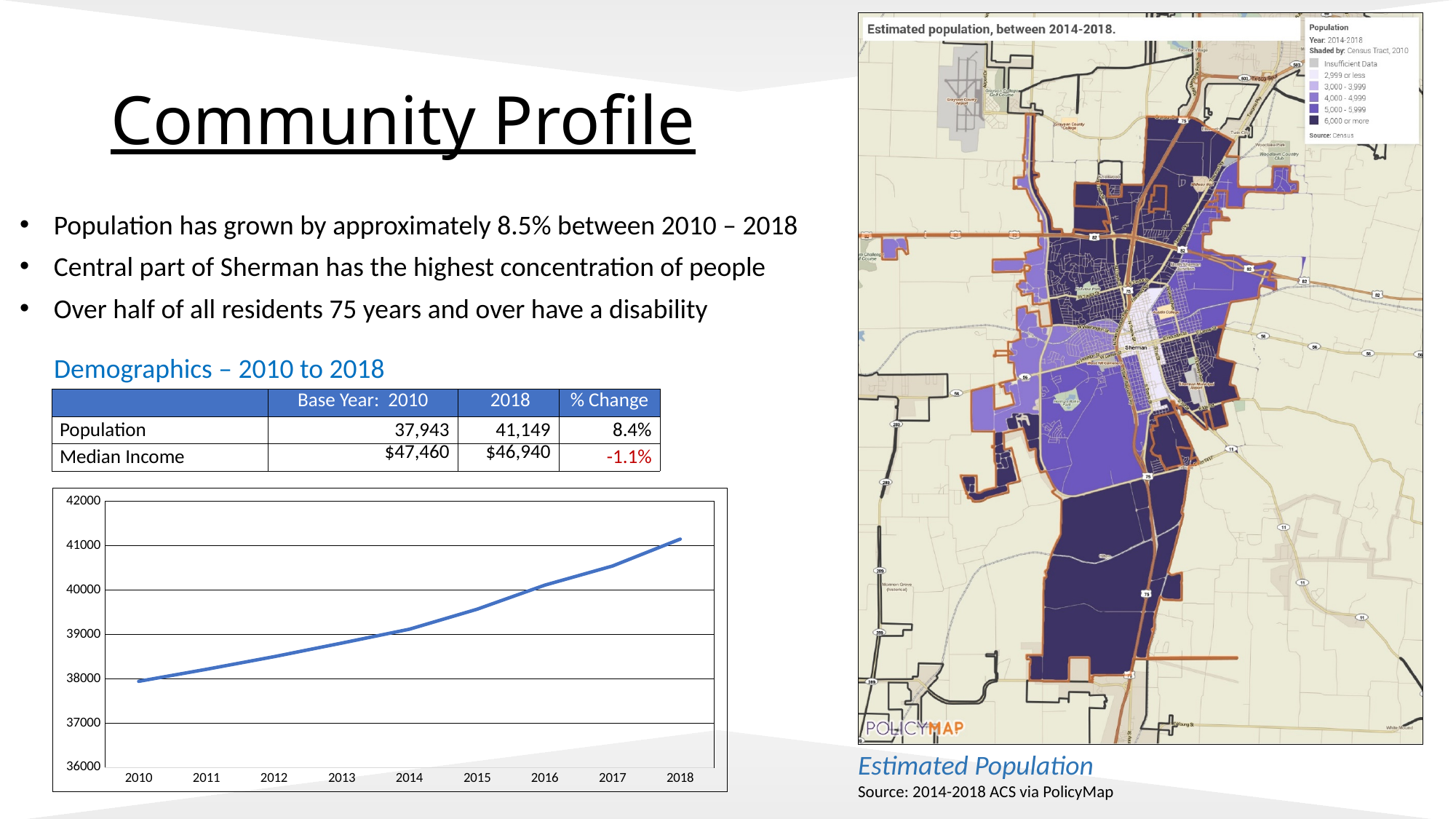
What kind of chart is shown at the bottom left of the slide? line chart In the line chart, which year has the lowest value? 2010 In the line chart, is the value for 2012 greater or less than 39000? less What is the lowest value shown on the y axis of the line chart? 36000 In the line chart, is the value for 2013 greater or less than 38000? greater In the line chart, do the values rise or fall from 2010 to 2018? rise In the line chart, is the value for 2015 greater or less than 40000? less What is the highest value shown on the y axis of the line chart? 42000 How many years are plotted along the x axis of the line chart? 9 In the line chart, which year has the highest value? 2018 In the line chart, which year has the larger value, 2012 or 2016? 2016